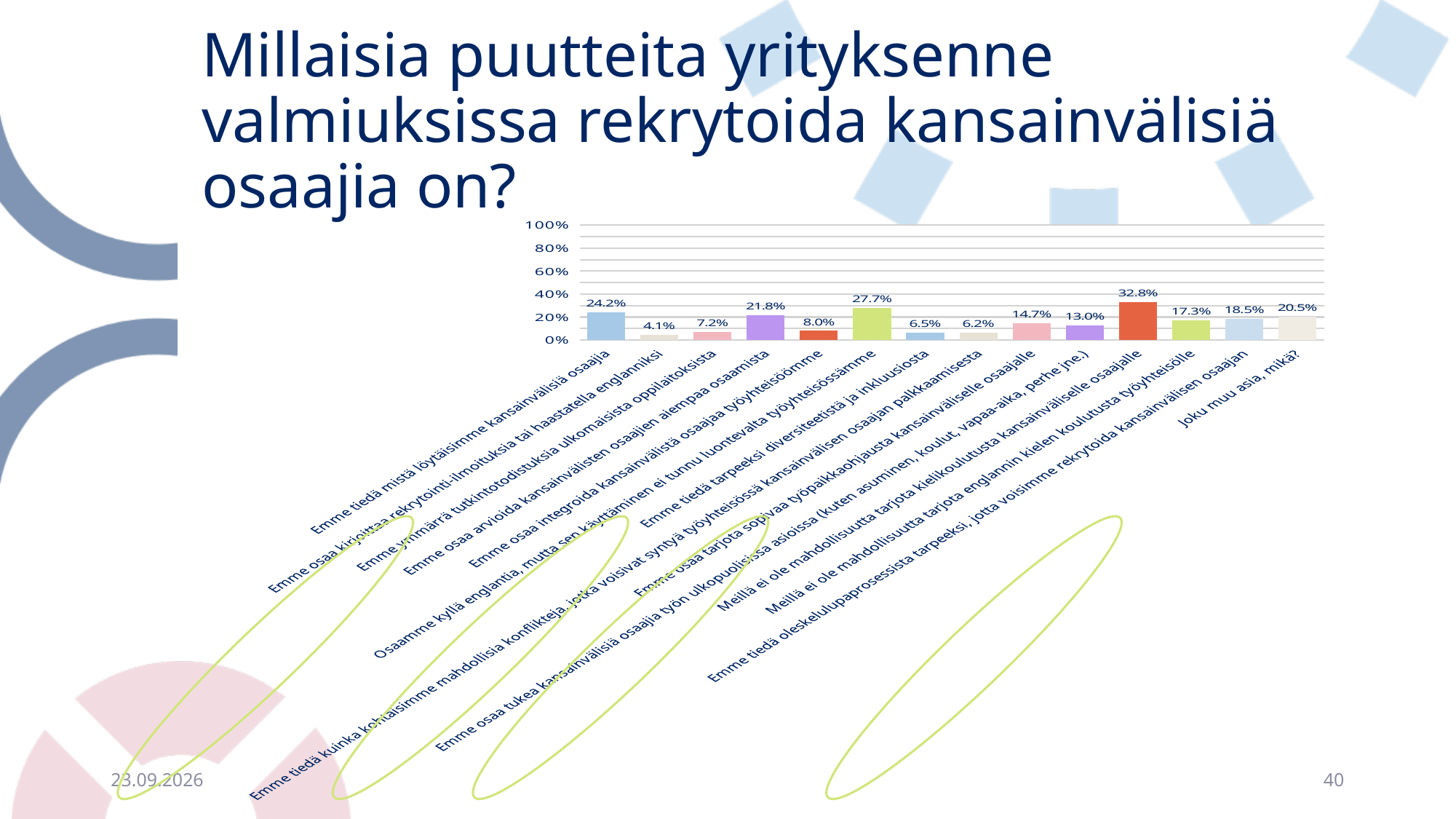
Is the value for "Emme tiedä oleskelulupaprosessista tarpeeksi, jotta voisimme rekrytoida kansainvälisen osaajan" greater or less than 20%? less What is the value for "Emme osaa kirjoittaa rekrytointi-ilmoituksia tai haastatella englanniksi"? 4.1% Which category has the highest value? Meillä ei ole mahdollisuutta tarjota kielikoulutusta kansainväliselle osaajalle What is the value for "Joku muu asia, mikä?"? 20.5% Which category has the lowest value? Emme osaa kirjoittaa rekrytointi-ilmoituksia tai haastatella englanniksi How many bars (categories) does the chart show? 14 What is the maximum value shown on the vertical axis? 100% What is the value for "Meillä ei ole mahdollisuutta tarjota englannin kielen koulutusta työyhteisölle"? 17.3% What is the difference between the highest value (32.8%) and the value for "Osaamme kyllä englantia, mutta sen käyttäminen ei tunnu luontevalta työyhteisössämme" (27.7%)? 5.1% What kind of chart is shown on the slide? bar chart What is the value for "Emme tiedä mistä löytäisimme kansainvälisiä osaajia"? 24.2% Which is larger: the value for "Emme osaa arvioida kansainvälisten osaajien aiempaa osaamista" or the value for "Emme osaa tarjota sopivaa työpaikkaohjausta kansainväliselle osaajalle"? Emme osaa arvioida kansainvälisten osaajien aiempaa osaamista